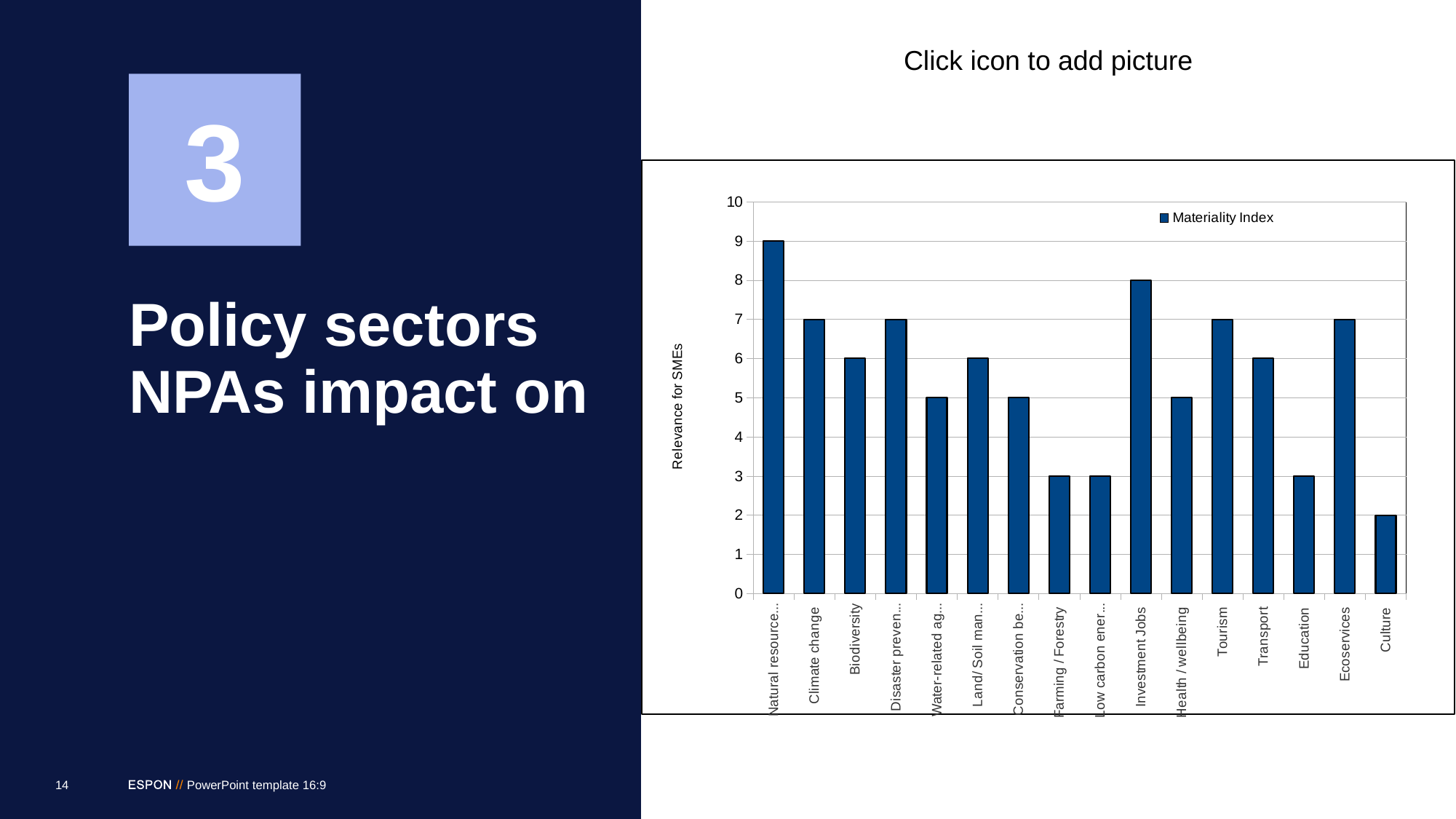
Which category has the lowest Materiality Index? Culture Which has a higher Materiality Index, Transport or Farming / Forestry? Transport How many series does the legend list? 1 What is the Materiality Index value for Education? 3 What is the Materiality Index value for Investment Jobs? 8 What is the label of the y axis? Relevance for SMEs What is the difference between the Materiality Index for Ecoservices and for Health / wellbeing? 2 Which has a higher Materiality Index, Investment Jobs or Tourism? Investment Jobs What type of chart is shown on the slide? bar chart What is the Materiality Index value for Culture? 2 How many categories are shown on the x axis of the chart? 16 What is the Materiality Index value for Tourism? 7